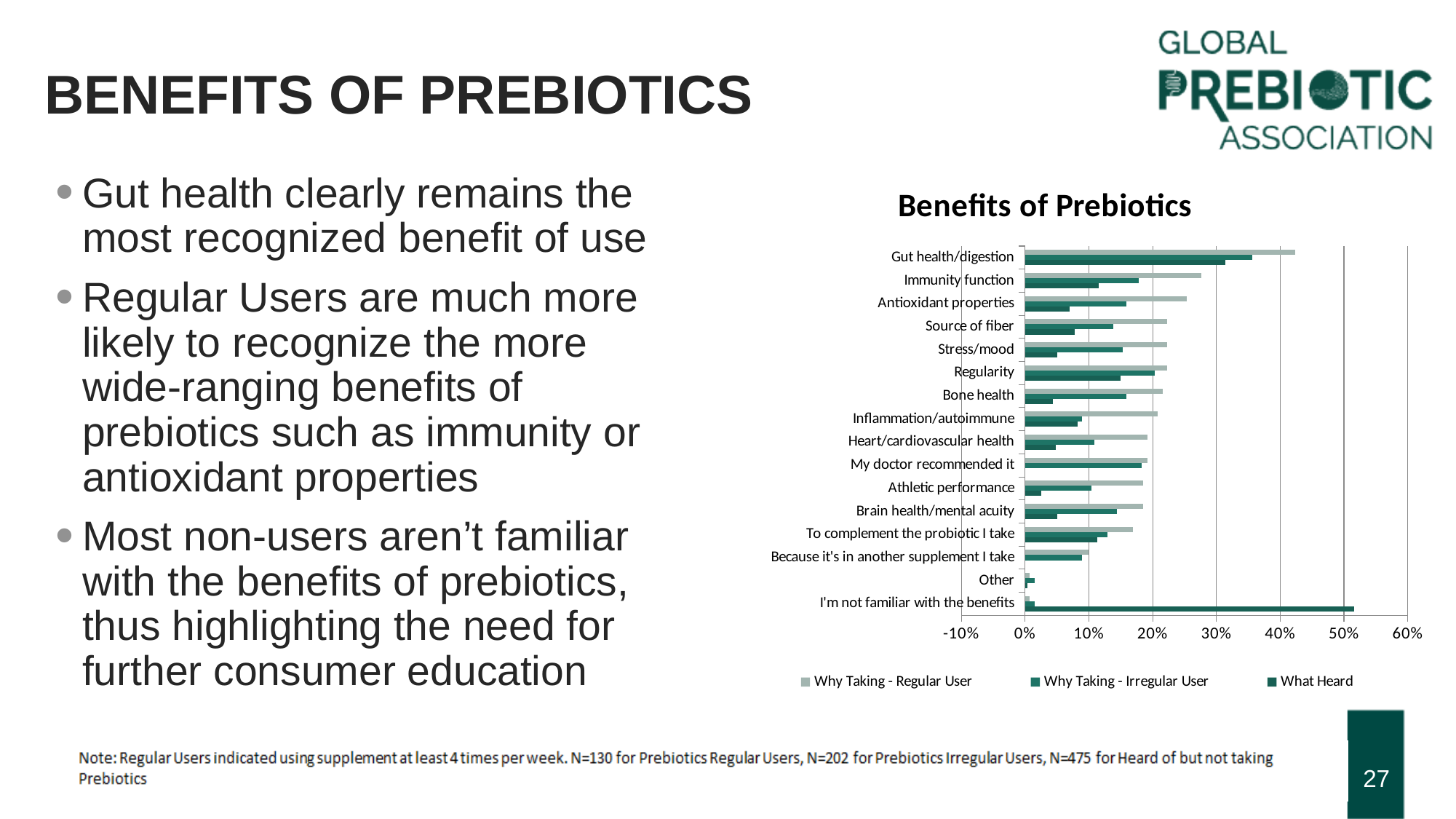
Which category has the highest value for the What Heard series? I'm not familiar with the benefits Which category has the highest value for the Why Taking - Regular User series? Gut health/digestion Is the What Heard value for I'm not familiar with the benefits greater or less than 40%? greater How many categories are plotted on the chart? 16 What type of chart is shown on the slide? Bar chart How many series does the chart legend list? 3 What is the title of the chart? Benefits of Prebiotics Is the Why Taking - Regular User value for Gut health/digestion greater or less than 40%? greater Is the What Heard value for Heart/cardiovascular health greater or less than 10%? less Which series is listed first in the chart legend? Why Taking - Regular User For Gut health/digestion, which is larger: the Why Taking - Regular User value or the What Heard value? Why Taking - Regular User